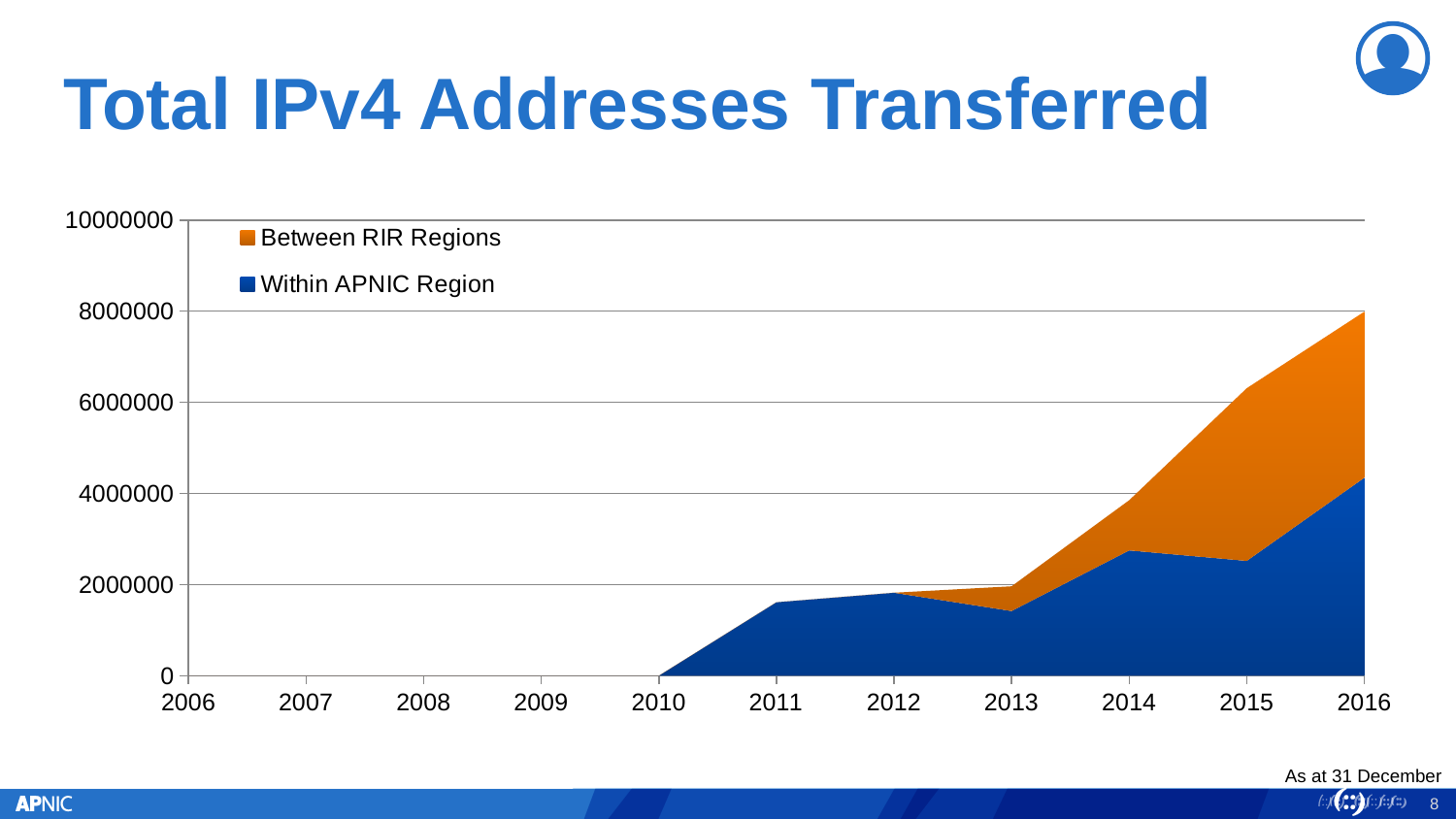
What are the two series named in the legend? Between RIR Regions; Within APNIC Region Which year has the larger Between RIR Regions value, 2014 or 2016? 2016 How many series does the legend list? 2 Is the value for Within APNIC Region in 2011 greater or less than 2000000? less Is the total value for 2016 greater or less than 6000000? greater What is the title of the chart? Total IPv4 Addresses Transferred Which year has the highest total of IPv4 addresses transferred? 2016 How many years are labelled on the x axis? 11 What is the total number of IPv4 addresses transferred in 2010? 0 Does the total number of addresses transferred rise or fall from 2010 to 2016? Rise What kind of chart is shown on the slide? Area chart Is the value for Within APNIC Region in 2014 greater or less than 2000000? greater